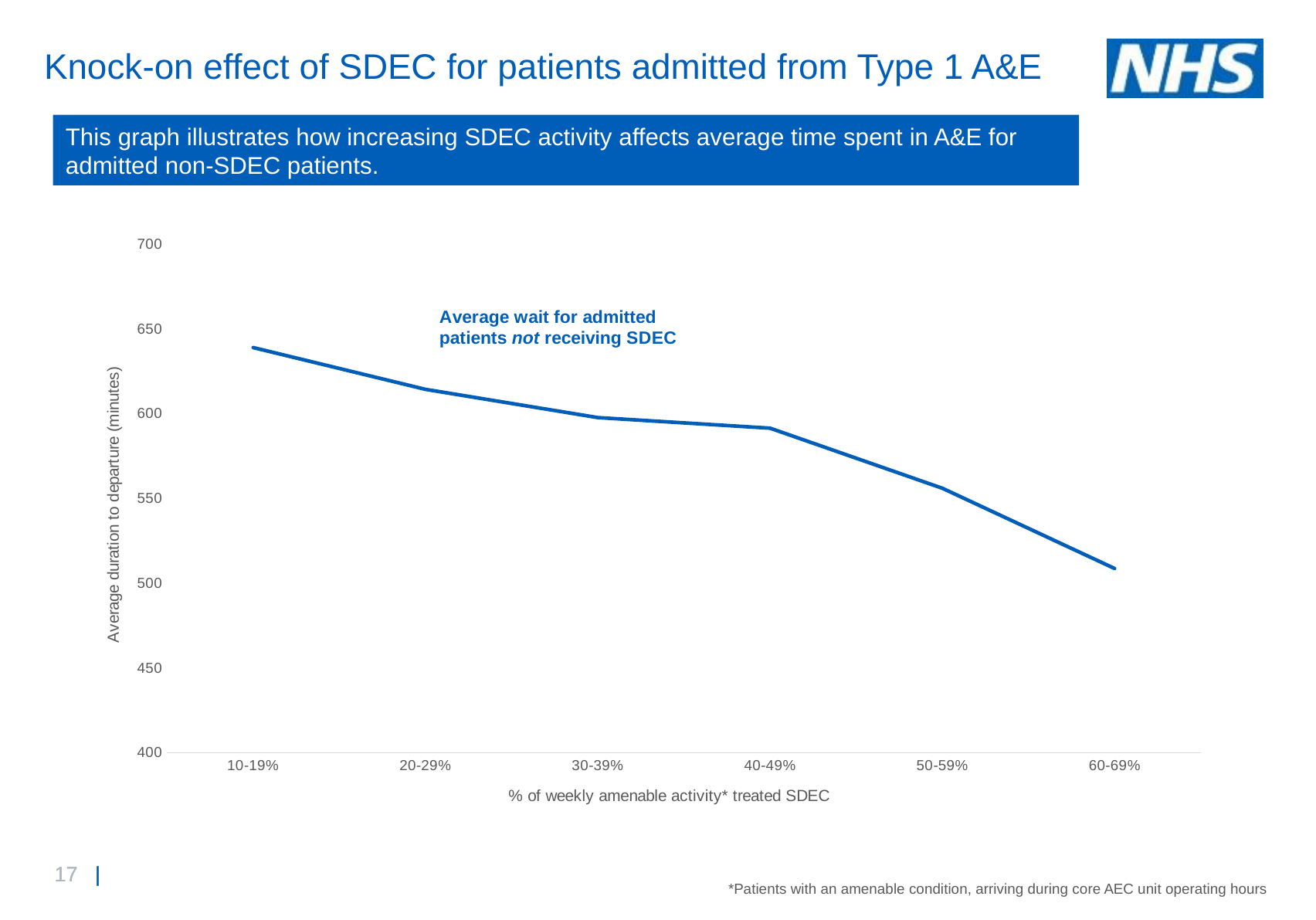
Which category has the highest average duration to departure? 10-19% Is the value for 40-49% greater or less than 550? greater What kind of chart is shown on the slide? line chart What is the label on the x axis? % of weekly amenable activity* treated SDEC Is the value for 10-19% greater or less than 600? greater Which is larger, the value for 20-29% or the value for 50-59%? 20-29% Is the value for 50-59% greater or less than 600? less What is the label on the y axis? Average duration to departure (minutes) How many categories are shown on the x axis? 6 Which category has the lowest average duration to departure? 60-69% Do the values rise or fall as the % of weekly amenable activity treated SDEC increases? fall